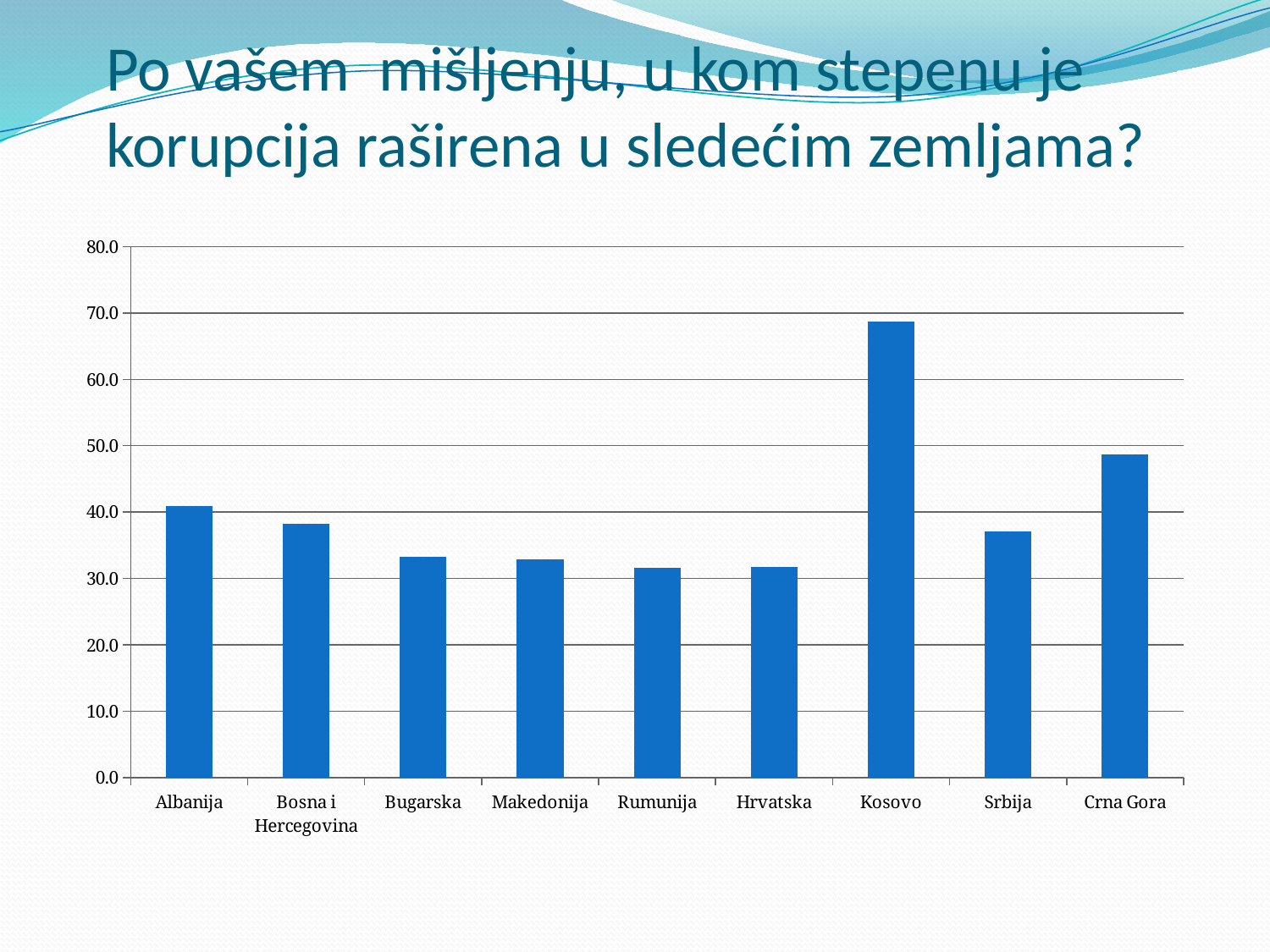
What is the title of the slide containing the chart? Po vašem mišljenju, u kom stepenu je korupcija raširena u sledećim zemljama? What kind of chart is shown on the slide? bar chart Is the value for Albanija greater or less than 30.0? greater Which has the larger value, Crna Gora or Albanija? Crna Gora Is the value for Srbija greater or less than 40.0? less How many countries are shown on the x axis of the chart? 9 Is the value for Rumunija greater or less than 40.0? less Which has the larger value, Kosovo or Crna Gora? Kosovo Which country has the highest bar in the chart? Kosovo